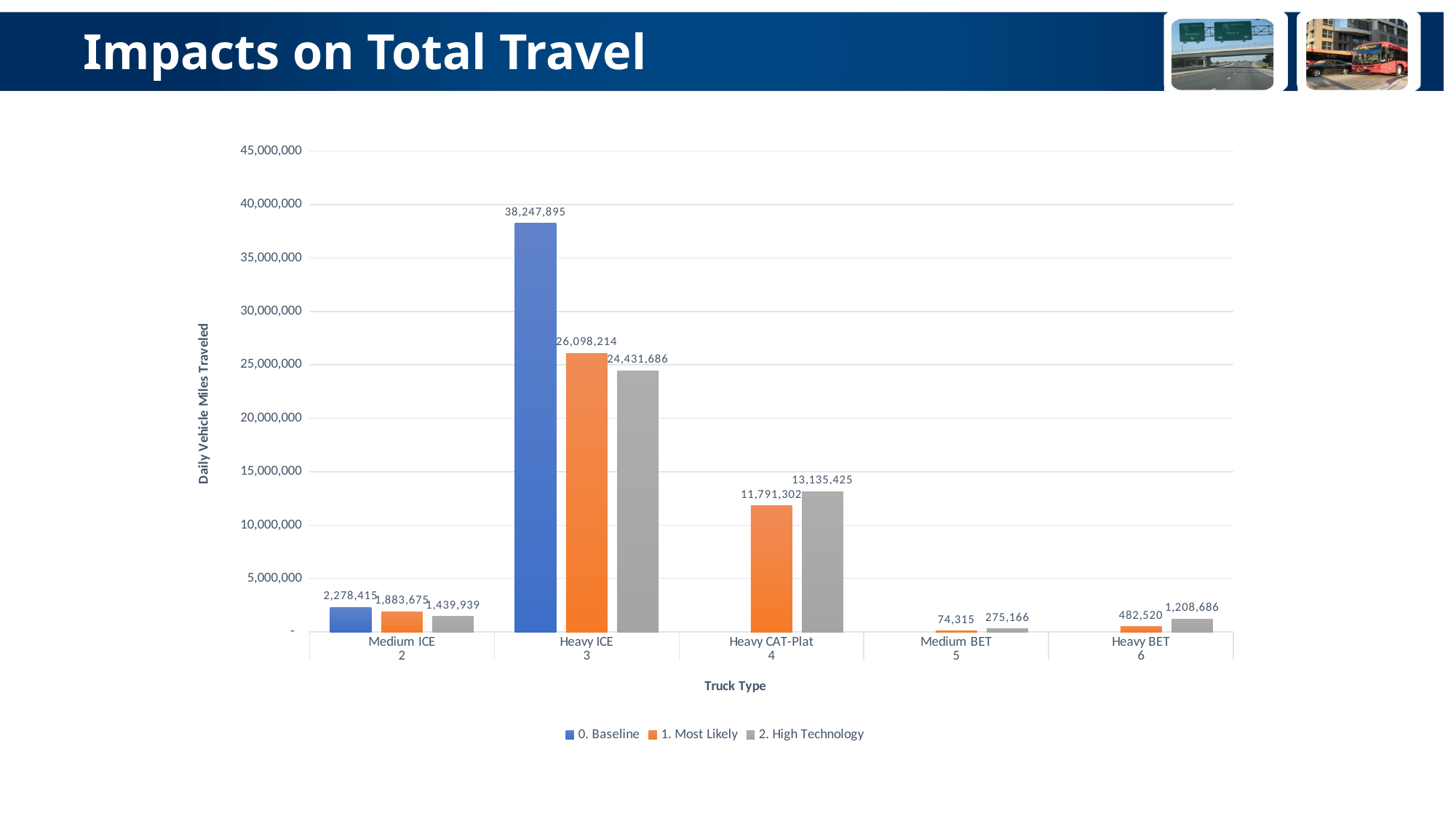
For Heavy BET, which is larger: the Most Likely value or the High Technology value? High Technology What kind of chart is shown on the slide? Bar chart Which truck type has the lowest Most Likely value? Medium BET How many truck type categories are shown on the x axis? 5 Which truck type has the highest Baseline value? Heavy ICE What is the difference between the Baseline and Most Likely values for Heavy ICE? 12,149,681 What is the High Technology value for Medium BET? 275,166 How many series does the legend list? 3 What is the Most Likely value for Heavy BET? 482,520 What is the difference between the High Technology and Most Likely values for Heavy CAT-Plat? 1,344,123 What is the Most Likely value for Heavy CAT-Plat? 11,791,302 What is the Baseline value for Heavy ICE? 38,247,895